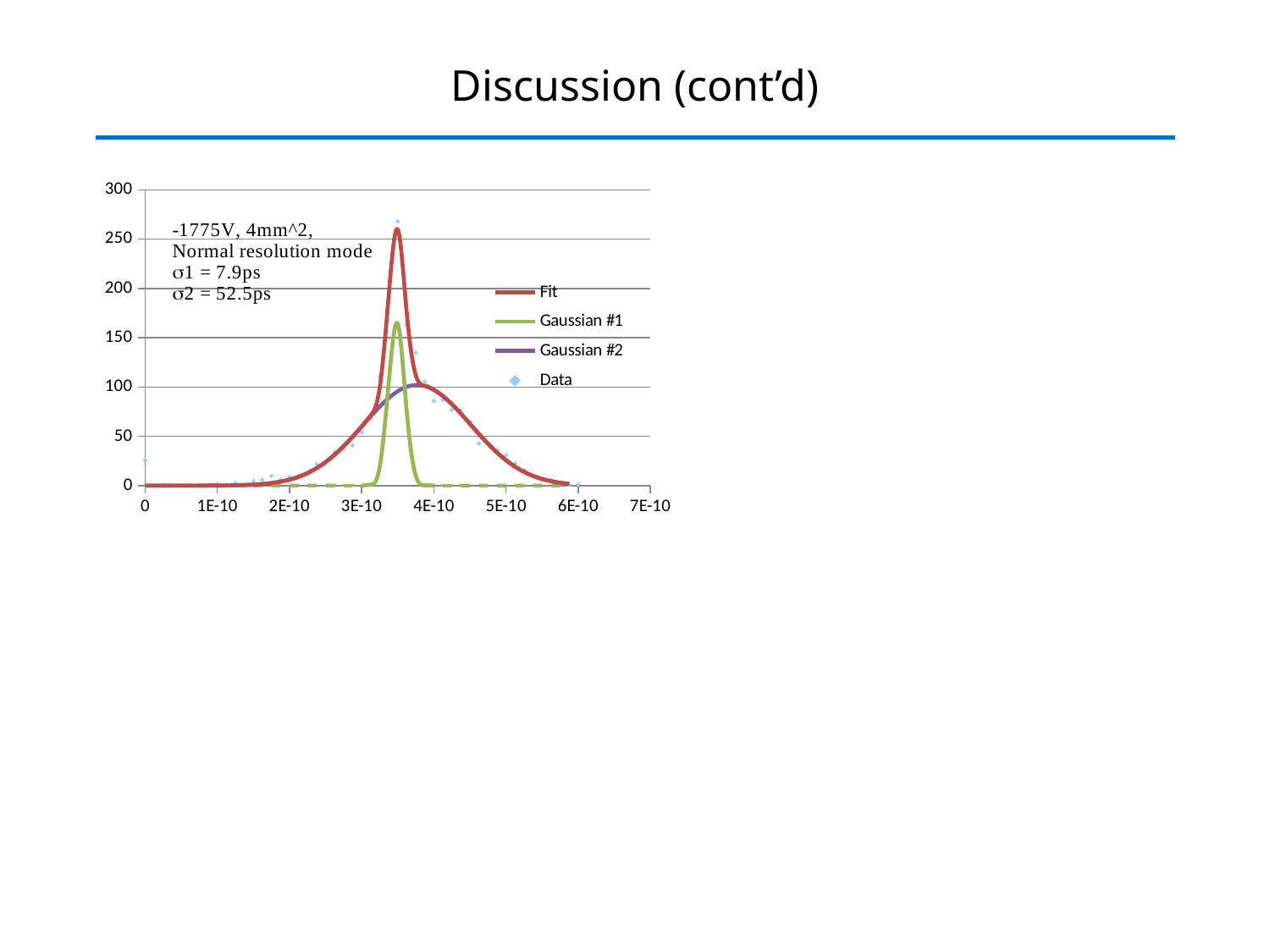
Does the Fit curve rise or fall between 2E-10 and 3E-10 on the x axis? rise How many series does the chart legend list? 4 Does the Fit curve rise or fall between 4E-10 and 6E-10 on the x axis? fall What is the highest value shown on the y axis? 300 Is the peak value of the Gaussian #2 curve greater or less than 150? less Is the peak value of the Fit curve greater or less than 200? greater What is the highest tick label shown on the x axis? 7E-10 What kind of chart is shown on the slide? line chart with scatter data points Which series reaches the highest peak value on the chart? Data Is the peak value of the Gaussian #1 curve greater or less than 150? greater Which has the higher peak, Gaussian #1 or Gaussian #2? Gaussian #1